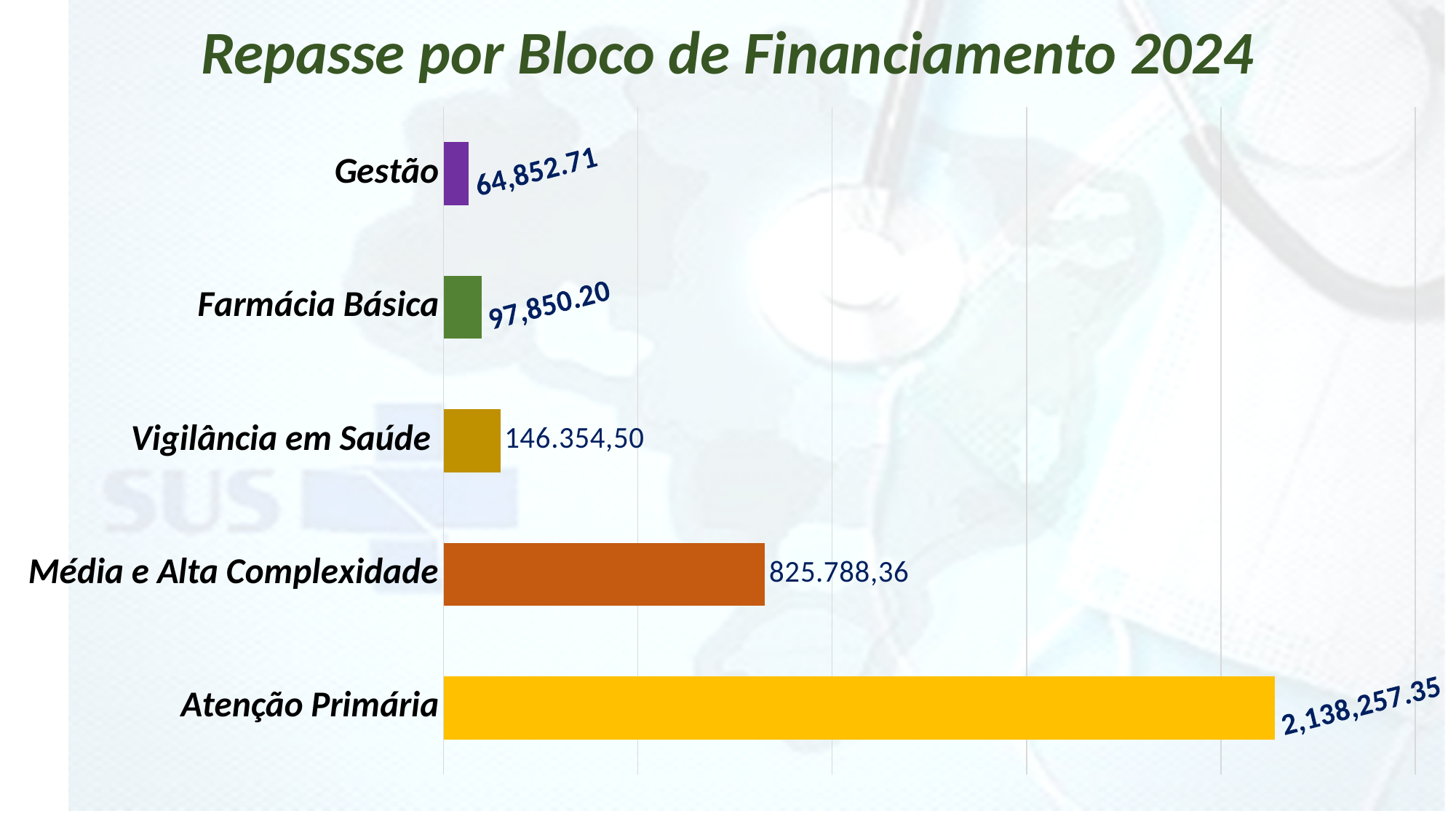
What is the difference between the values for Farmácia Básica and Gestão? 32,997.49 What is the value for Vigilância em Saúde? 146.354,50 What kind of chart is shown on the slide? Bar chart What is the title of the chart? Repasse por Bloco de Financiamento 2024 How many categories are shown in the chart? 5 What is the value for Atenção Primária? 2,138,257.35 What is the value for Média e Alta Complexidade? 825.788,36 Which is larger, the value for Vigilância em Saúde or the value for Farmácia Básica? Vigilância em Saúde What is the value for Farmácia Básica? 97,850.20 Which category has the lowest value? Gestão Which category has the highest value? Atenção Primária What is the value for Gestão? 64,852.71